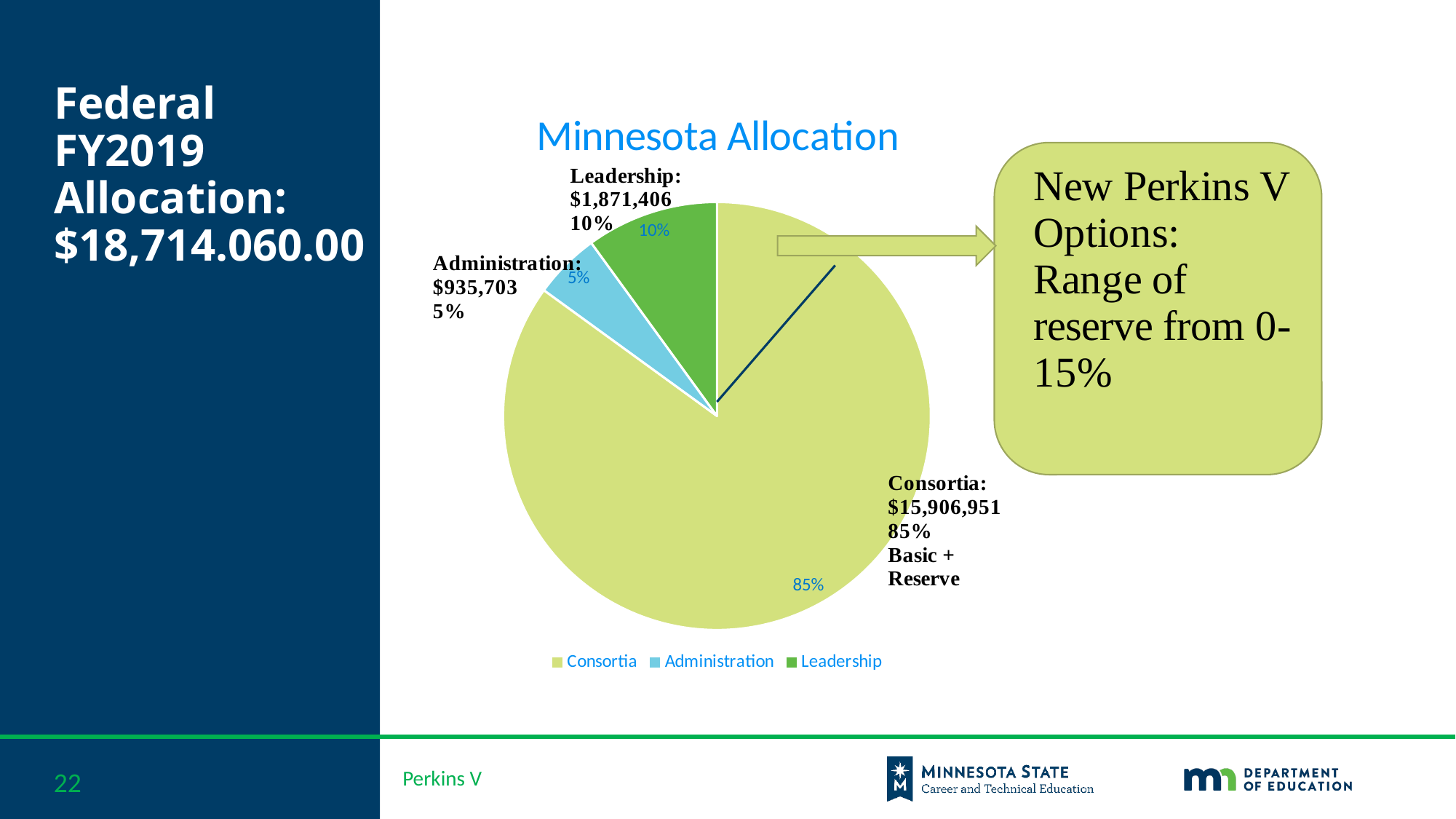
What percentage of the allocation goes to Administration? 5% What percentage of the allocation goes to Consortia? 85% What kind of chart is shown on the slide? pie chart What is the title of the chart? Minnesota Allocation What is the dollar amount allocated to Leadership? $1,871,406 Which category receives the largest share of the allocation? Consortia What is the dollar amount allocated to Administration? $935,703 Which category receives the smallest share of the allocation? Administration What is the dollar amount allocated to Consortia? $15,906,951 How many slices does the pie chart have? 3 What percentage of the allocation goes to Leadership? 10% How many entries does the legend list? 3